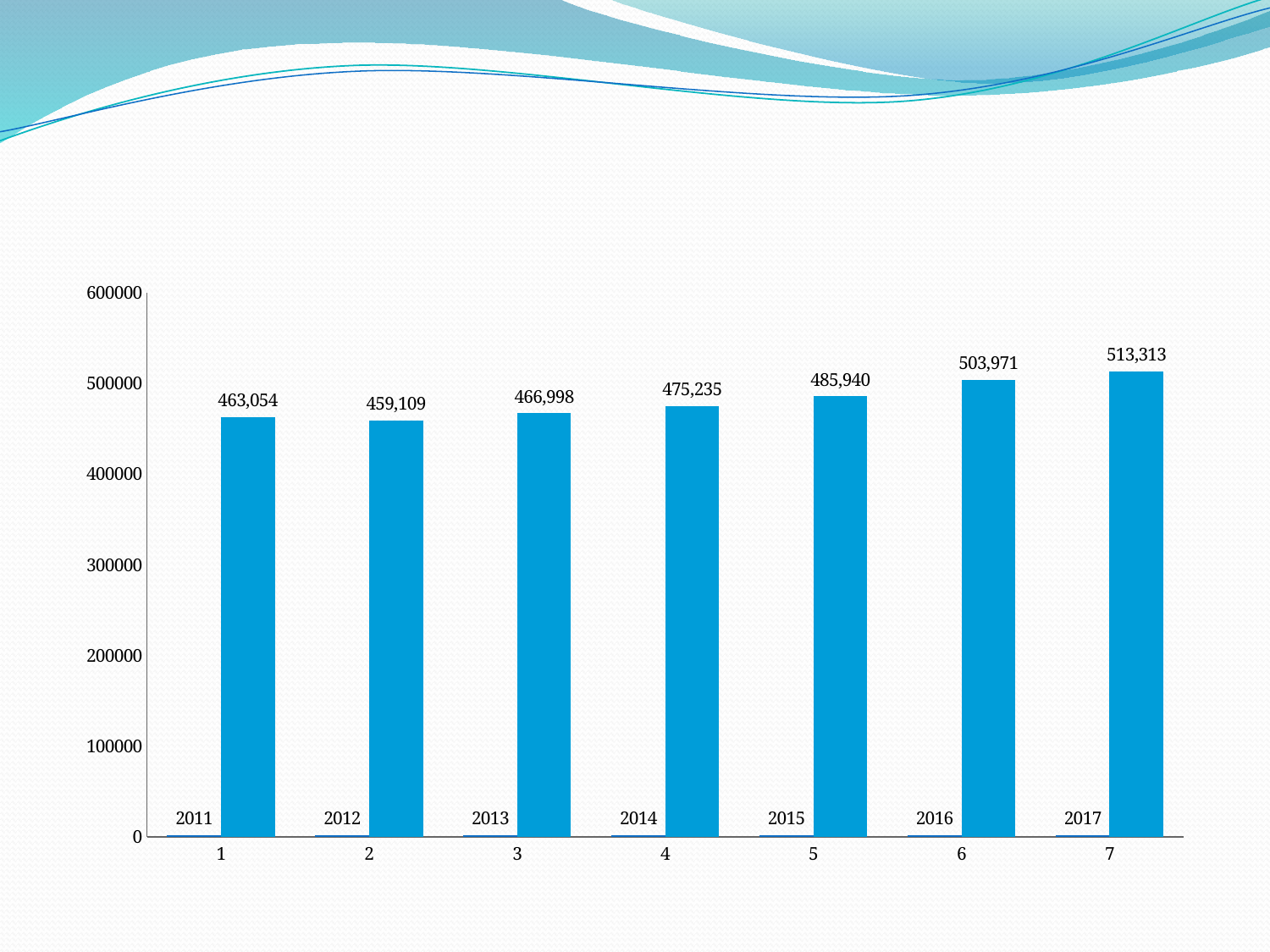
Which category has the shortest bar? 2 (2012) What is the value of the bar for category 1 (labelled 2011)? 463,054 How many categories are shown on the x axis? 7 What is the value of the bar for category 7 (labelled 2017)? 513,313 What kind of chart is shown on the slide? bar chart Which is larger, the bar for category 3 (2013) or the bar for category 2 (2012)? category 3 (2013) From category 2 (2012) to category 7 (2017), do the bar values rise or fall? rise What is the value of the bar for category 4 (labelled 2014)? 475,235 Which category has the tallest bar? 7 (2017) What is the difference between the bar values for category 7 (2017) and category 1 (2011)? 50,259 Is the value for category 6 (2016) greater or less than 500000? greater What is the difference between the bar values for category 6 (2016) and category 5 (2015)? 18,031